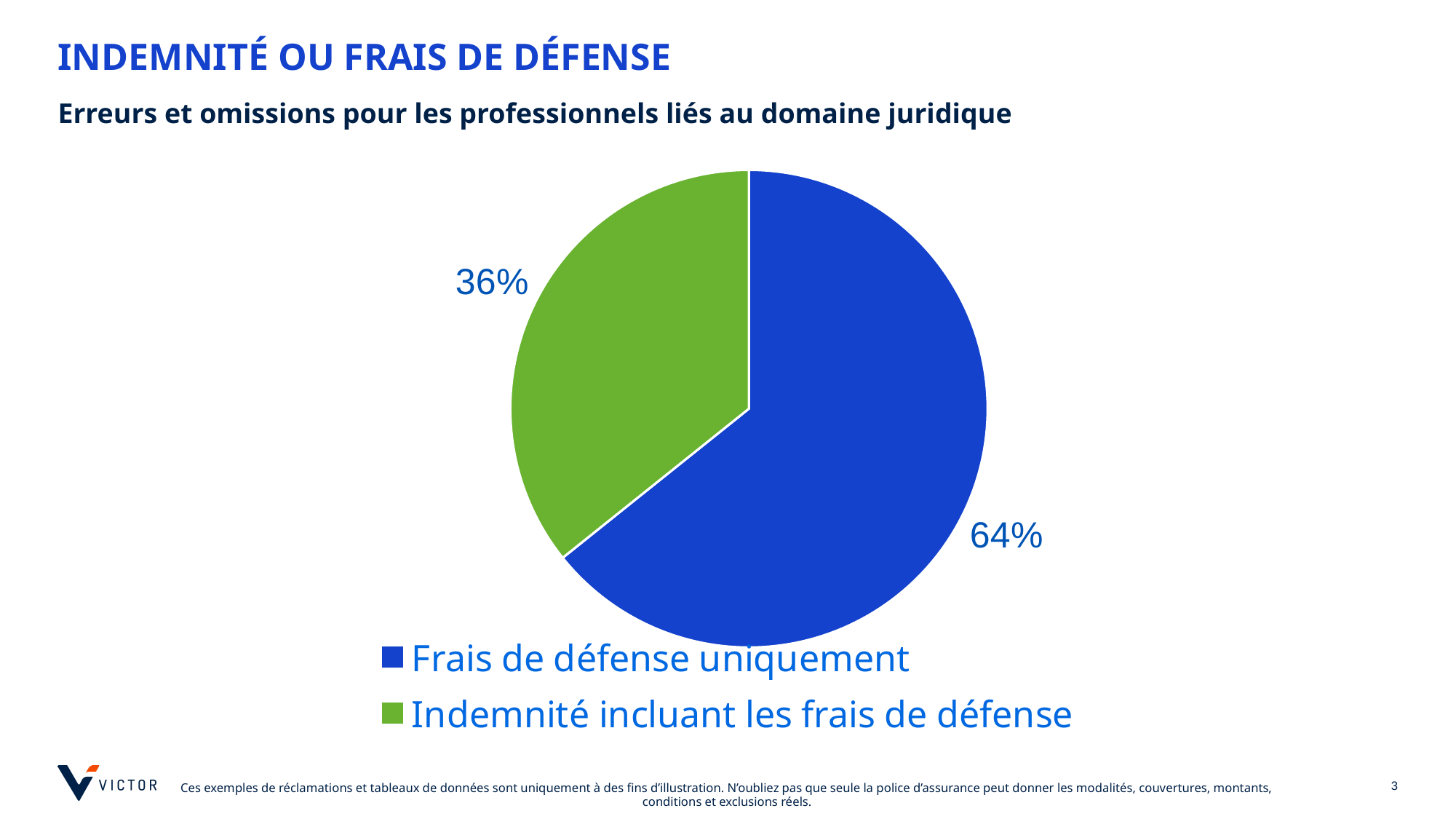
How many slices does the pie chart have? 2 What colour is the "Frais de défense uniquement" slice? blue What share of the pie does "Indemnité incluant les frais de défense" represent? 36% What kind of chart is shown on the slide? pie chart Which is larger: the share for "Frais de défense uniquement" or the share for "Indemnité incluant les frais de défense"? Frais de défense uniquement What colour is the "Indemnité incluant les frais de défense" slice? green What is the difference in percentage points between the "Frais de défense uniquement" slice and the "Indemnité incluant les frais de défense" slice? 28 What share of the pie does "Frais de défense uniquement" represent? 64% Which slice of the pie is the largest? Frais de défense uniquement Which slice of the pie is the smallest? Indemnité incluant les frais de défense How many entries does the legend list? 2 Is the share for "Indemnité incluant les frais de défense" greater or less than 50%? less